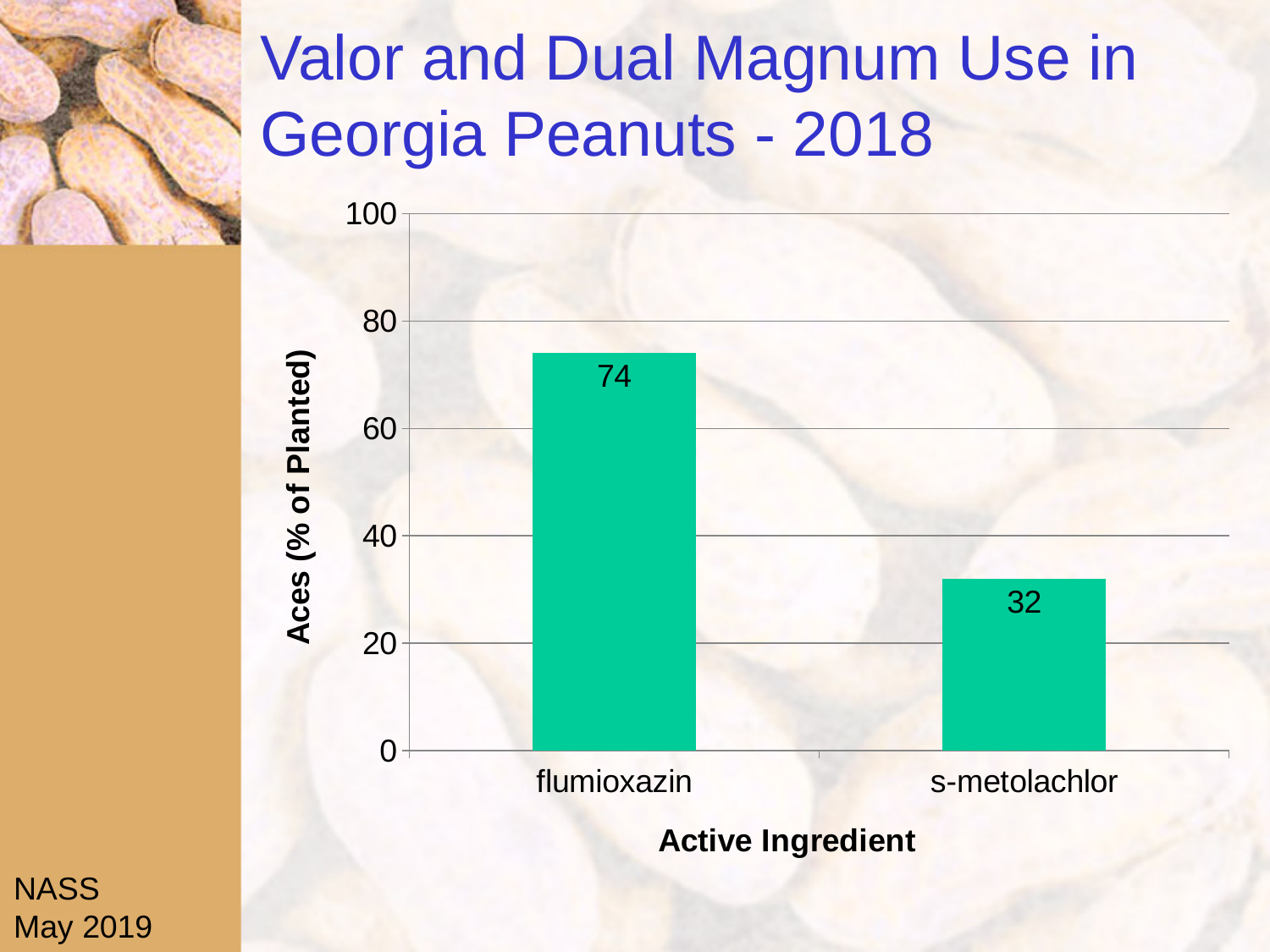
What is the value for flumioxazin? 74 Which active ingredient has the highest value? flumioxazin Which active ingredient has the lowest value? s-metolachlor What is the difference between the values for flumioxazin and s-metolachlor? 42 What is the label of the x axis? Active Ingredient What is the label of the y axis? Aces (% of Planted) Is the value for s-metolachlor greater or less than 40? less Which is larger, the value for flumioxazin or the value for s-metolachlor? flumioxazin What is the value for s-metolachlor? 32 Is the value for flumioxazin greater or less than 60? greater What kind of chart is shown on the slide? bar chart How many active ingredients are shown on the chart? 2